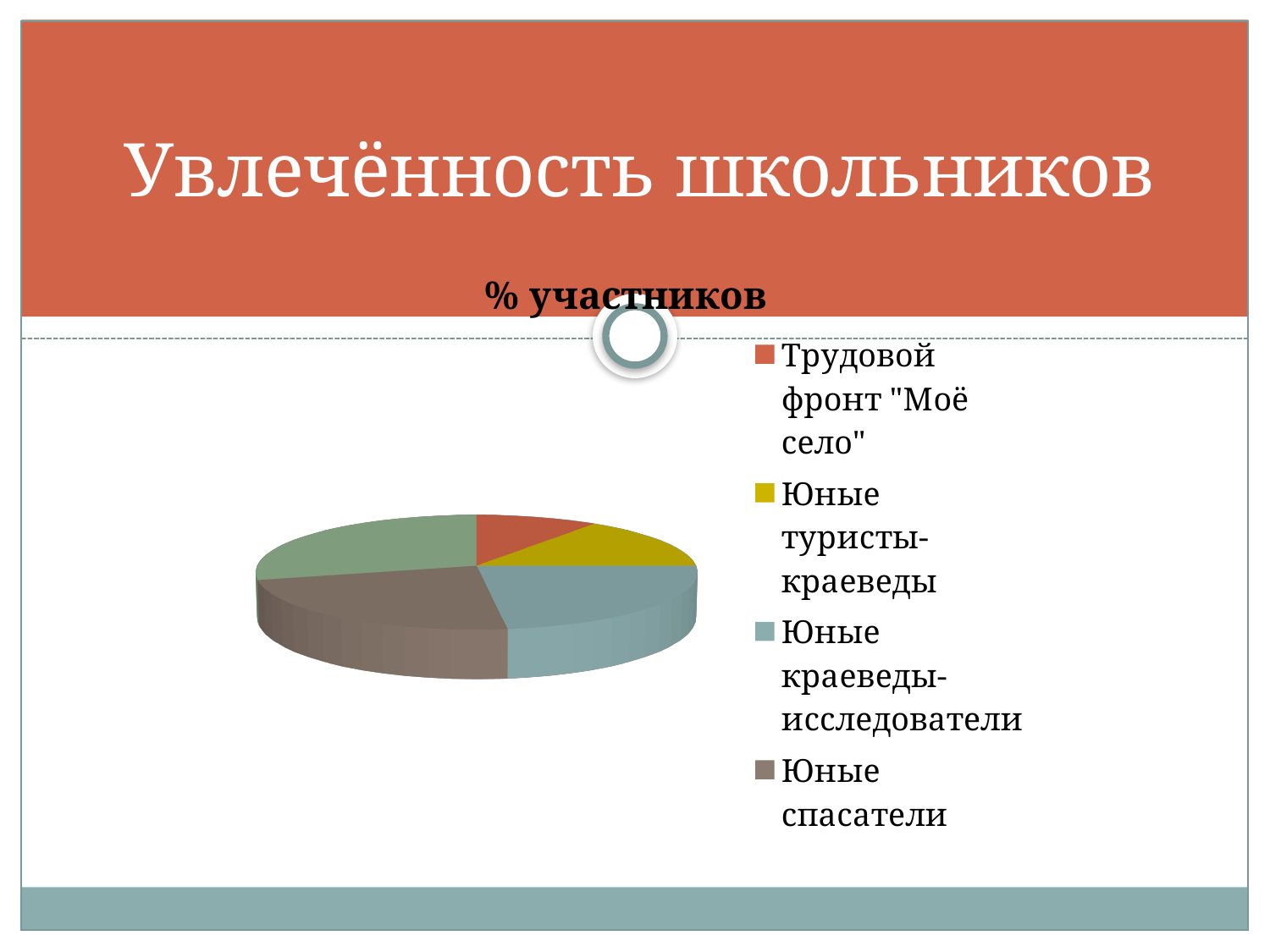
Which slice is larger: Юные краеведы-исследователи or Юные туристы-краеведы? Юные краеведы-исследователи Which legend category has the smallest slice of the pie? Трудовой фронт "Моё село" What is the title of the chart? % участников What colour represents Юные спасатели in the pie chart? brown Which slice is larger: Юные краеведы-исследователи or Трудовой фронт "Моё село"? Юные краеведы-исследователи How many slices does the pie chart have? 5 What kind of chart is shown on the slide? pie chart Which slice is larger: Юные спасатели or Трудовой фронт "Моё село"? Юные спасатели How many entries does the chart legend list? 4